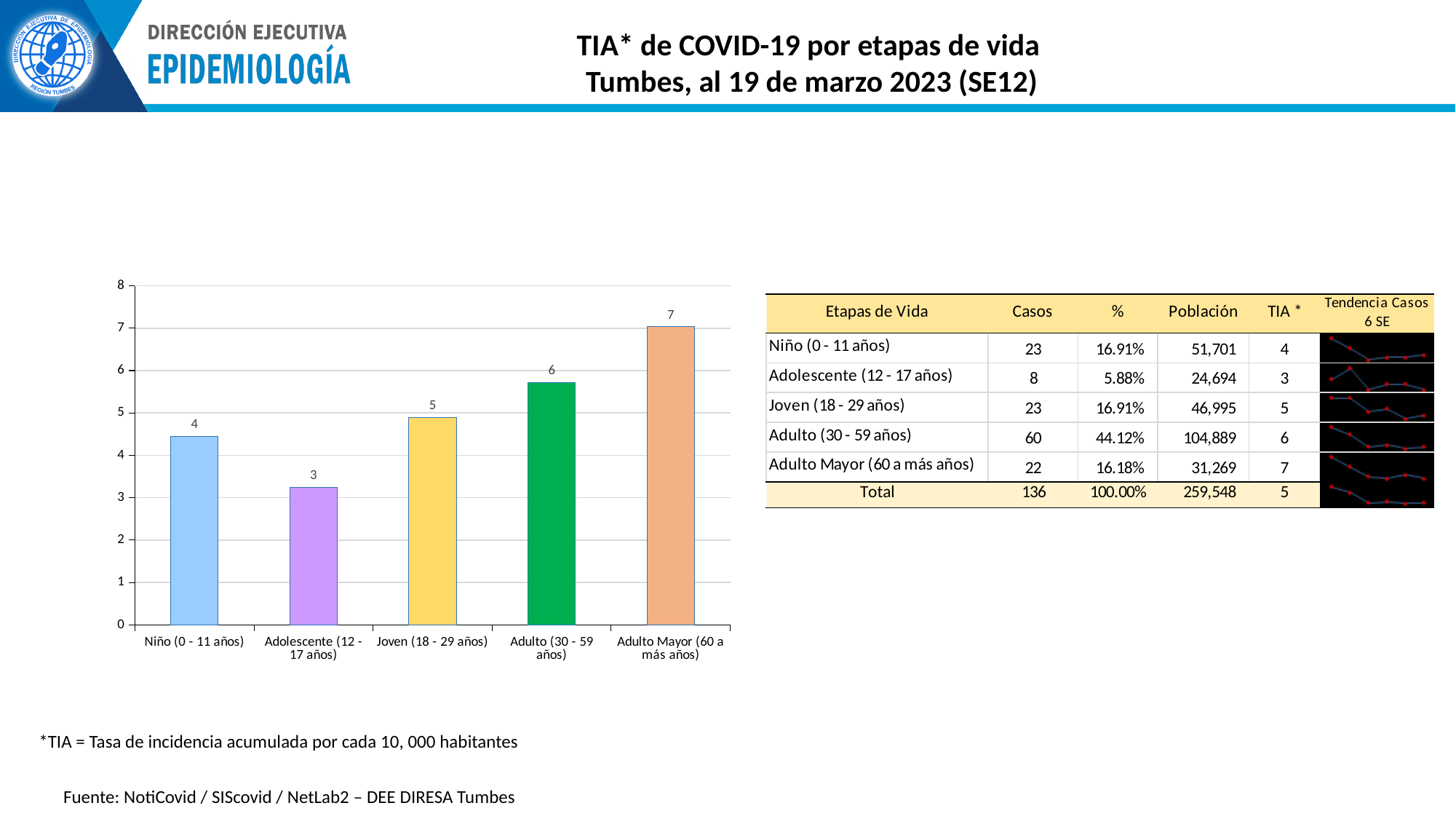
Using the data labels, what is the difference between Adulto Mayor (60 a más años) and Adolescente (12 - 17 años)? 4 Which is larger in the bar chart, the value for Joven (18 - 29 años) or the value for Niño (0 - 11 años)? Joven (18 - 29 años) What is the maximum value shown on the vertical axis of the bar chart? 8 Which category has the lowest bar in the chart? Adolescente (12 - 17 años) Which category has the highest bar in the chart? Adulto Mayor (60 a más años) What is the data label shown for Niño (0 - 11 años) in the bar chart? 4 Is the bar for Adolescente (12 - 17 años) greater or less than 4 on the axis? less How many age-group categories are plotted in the bar chart? 5 What is the data label shown for Adolescente (12 - 17 años) in the bar chart? 3 What type of chart is shown on the slide? bar chart What is the data label shown for Adulto (30 - 59 años) in the bar chart? 6 Is the bar for Adulto Mayor (60 a más años) greater or less than 6 on the axis? greater